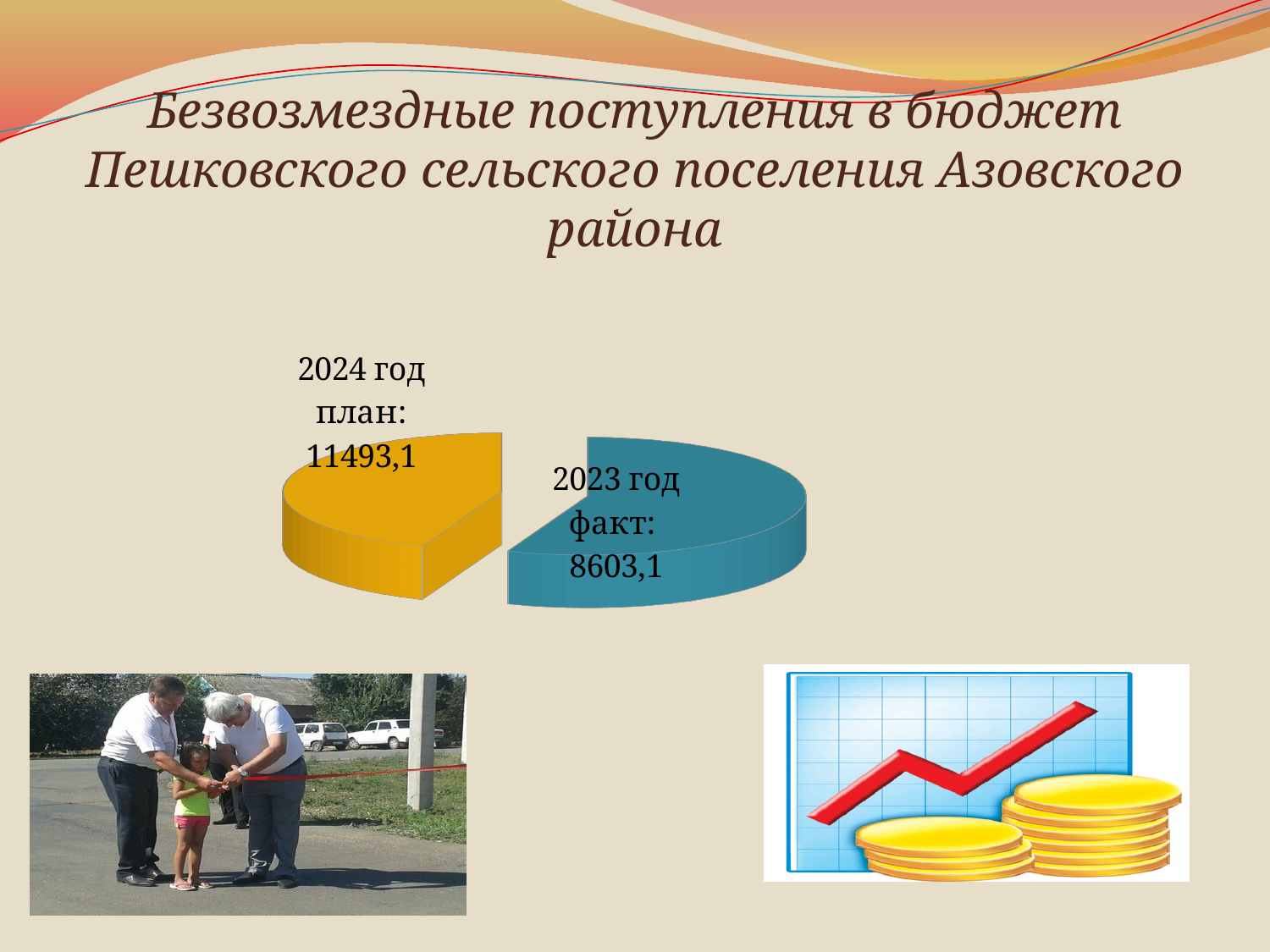
How many slices does the pie chart have? 2 By how much does the 2024 год план value exceed the 2023 год факт value in the pie chart? 2890,0 What colour is the 2024 год план slice of the pie chart? yellow Which slice of the pie chart has the smaller value? 2023 год факт What is the value shown for the 2024 год план slice of the pie chart? 11493,1 What kind of chart is shown on the slide? pie chart What colour is the 2023 год факт slice of the pie chart? blue Is the value for 2023 год факт larger or smaller than the value for 2024 год план? smaller Which slice of the pie chart has the larger value? 2024 год план What is the value shown for the 2023 год факт slice of the pie chart? 8603,1